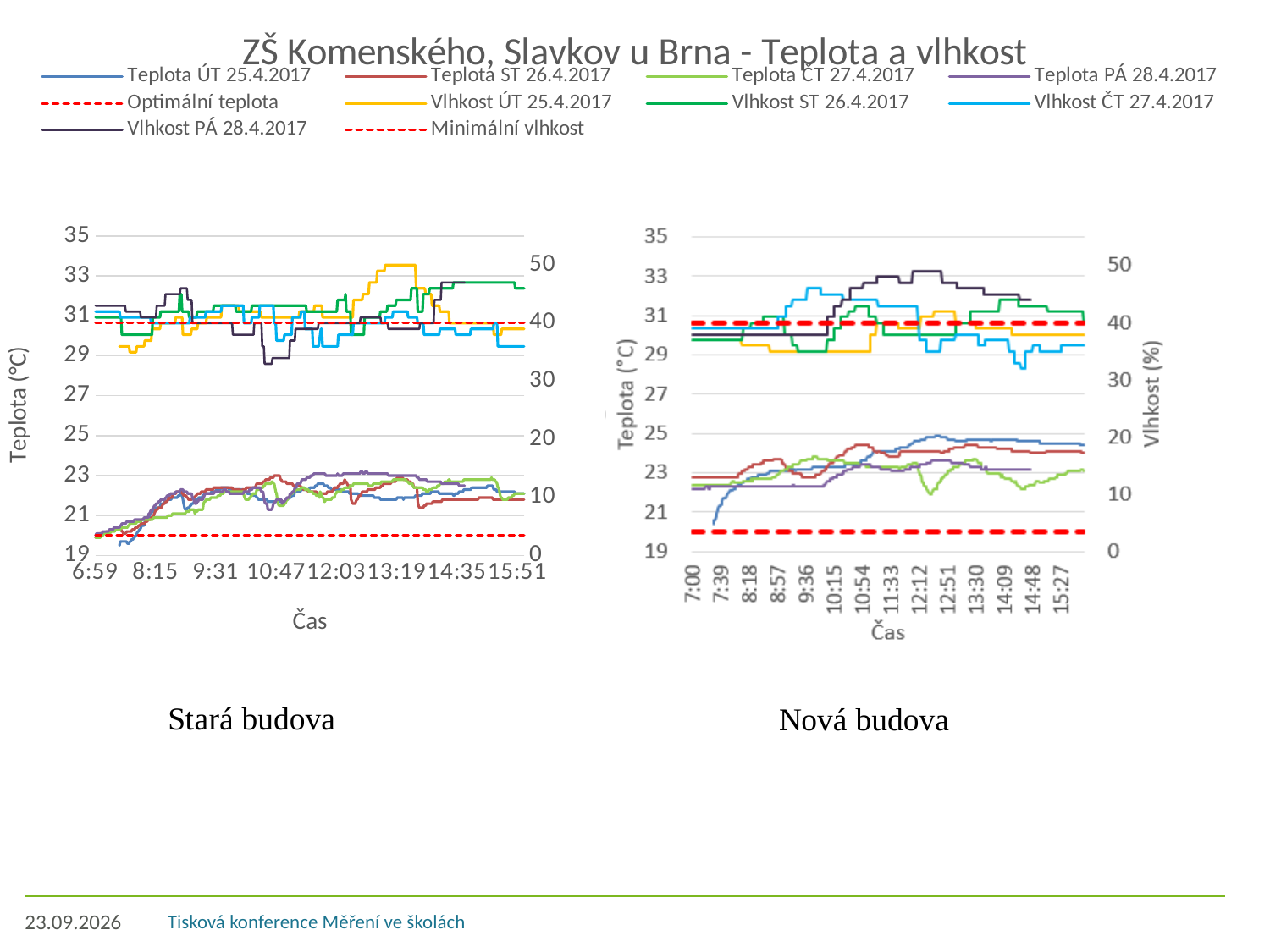
In the Stará budova chart, is the Teplota ST 26.4.2017 value at 13:19 greater or less than 25? less What kind of chart is the Stará budova chart? line chart What is the title of the slide's chart? ZŠ Komenského, Slavkov u Brna - Teplota a vlhkost In the Nová budova chart, is the peak value of Vlhkost PÁ 28.4.2017 greater or less than 40? greater What kind of chart is the Nová budova chart? line chart In the Stará budova chart, is the peak value of Vlhkost ÚT 25.4.2017 greater or less than 40? greater How many series does the legend list? 10 In the Nová budova chart, what is the label of the right vertical axis? Vlhkost (%)